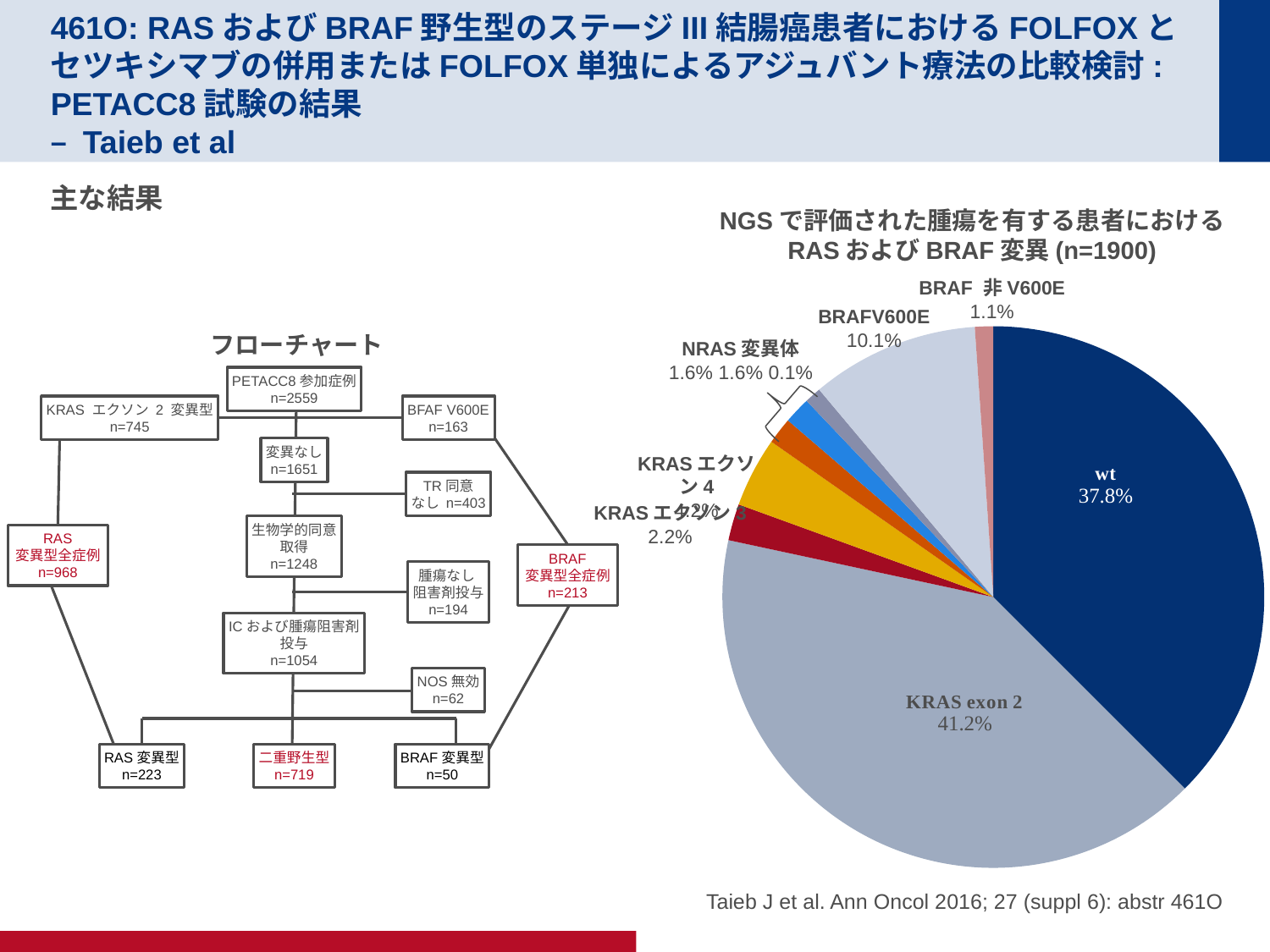
In the pie chart, which is larger: BRAFV600E or KRAS エクソン 3? BRAFV600E In the pie chart, what percentage is shown for KRAS エクソン 3? 2.2% What kind of chart is shown on the right side of the slide? Pie chart In the pie chart, what percentage is shown for KRAS exon 2? 41.2% In the pie chart, what is the difference between BRAFV600E and BRAF 非 V600E? 9.0% According to the pie chart title, how many patients (n) were evaluated by NGS? n=1900 Which slice of the pie chart is the largest? KRAS exon 2 In the pie chart, how many percentage points larger is KRAS exon 2 than wt? 3.4% In the pie chart, what percentage is shown for the wt slice? 37.8% In the pie chart, what percentage is shown for BRAFV600E? 10.1% In the pie chart, which is larger: wt or KRAS exon 2? KRAS exon 2 In the pie chart, what percentage is shown for BRAF 非 V600E? 1.1%